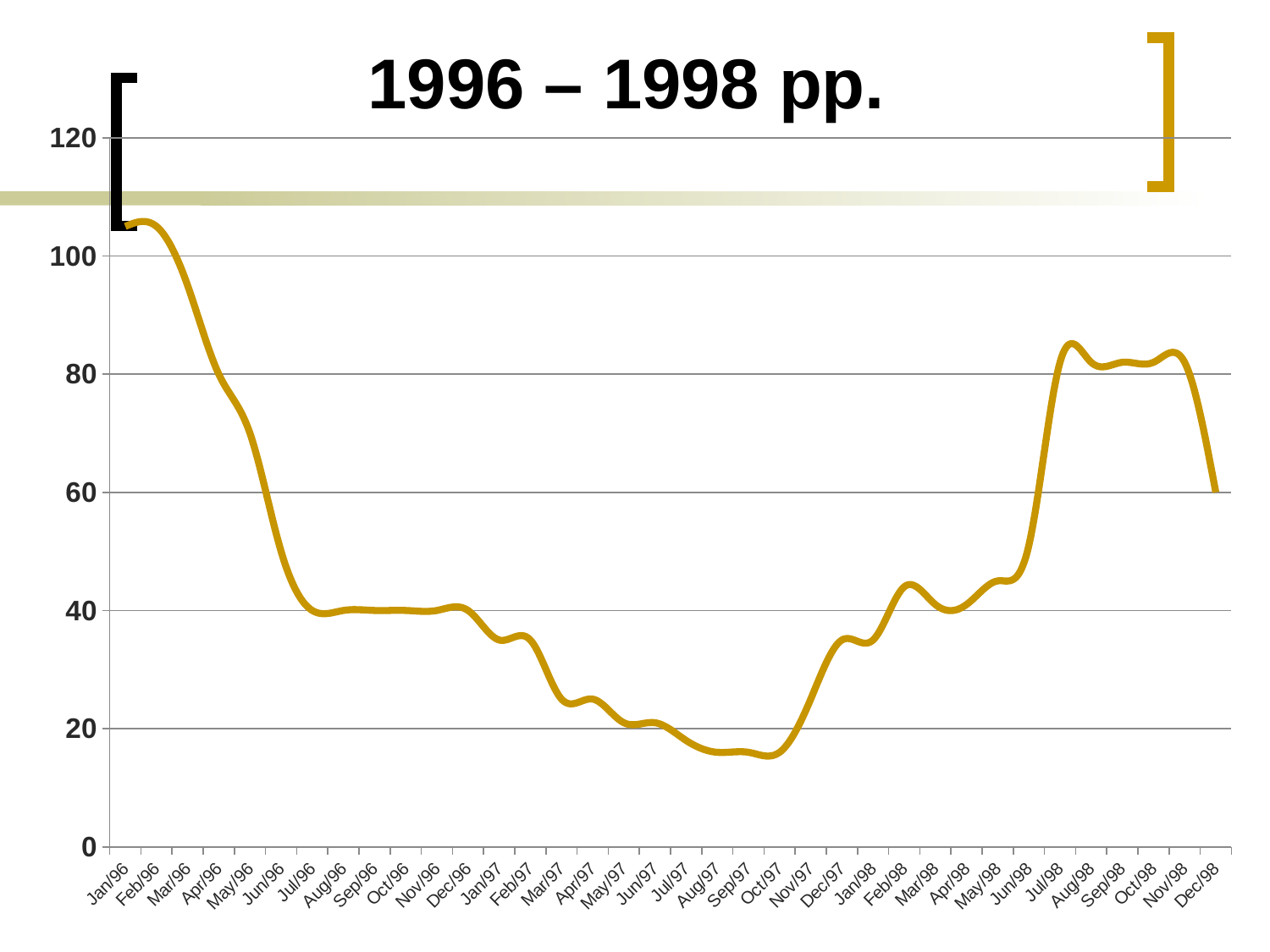
What kind of chart is shown on the slide? line chart Do the values rise or fall from Jan/96 to Jul/96? fall Is the value for Oct/97 greater or less than 20? less Is the value for Apr/96 greater or less than 60? greater What is the title of the chart? 1996 – 1998 pp. Is the value for Jan/96 greater or less than 100? greater Which is larger, the value for Jan/96 or the value for Dec/98? Jan/96 How many monthly points are plotted along the x axis? 36 What is the highest value shown on the y axis? 120 Do the values rise or fall from Oct/97 to Jul/98? rise